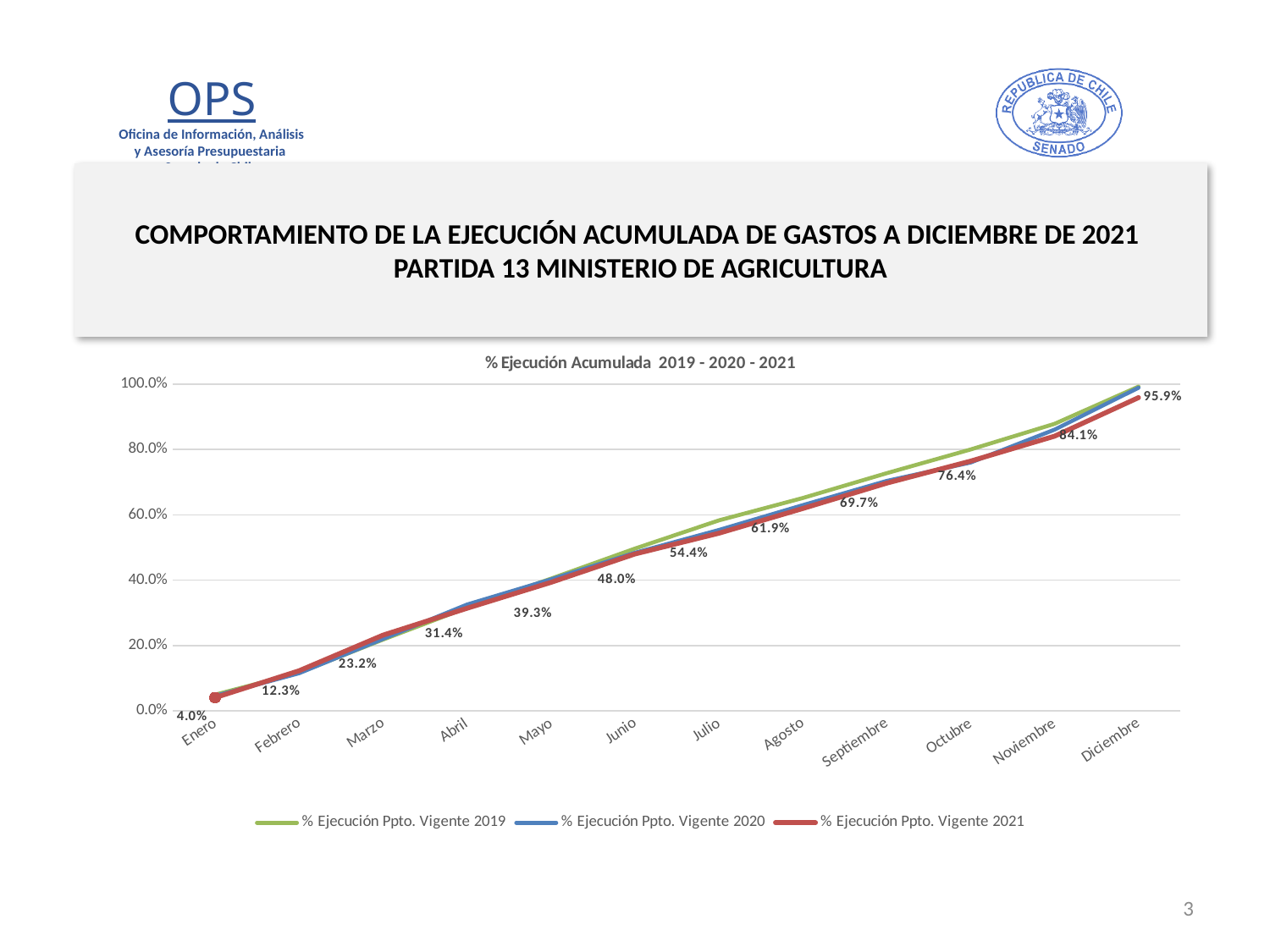
What is the value of % Ejecución Ppto. Vigente 2021 for Octubre? 76.4% What is the value of % Ejecución Ppto. Vigente 2021 for Diciembre? 95.9% What is the difference between the % Ejecución Ppto. Vigente 2021 values for Diciembre and Noviembre? 11.8% What is the title of the chart? % Ejecución Acumulada 2019 - 2020 - 2021 In which month is the % Ejecución Ppto. Vigente 2021 series lowest? Enero What type of chart is shown on the slide? line chart In which month is the % Ejecución Ppto. Vigente 2021 series highest? Diciembre How many series does the legend list? 3 Do the values of the % Ejecución Ppto. Vigente 2021 series rise or fall from Enero to Diciembre? rise How many months are plotted along the x axis? 12 What is the value of % Ejecución Ppto. Vigente 2021 for Enero? 4.0% What is the value of % Ejecución Ppto. Vigente 2021 for Junio? 48.0%